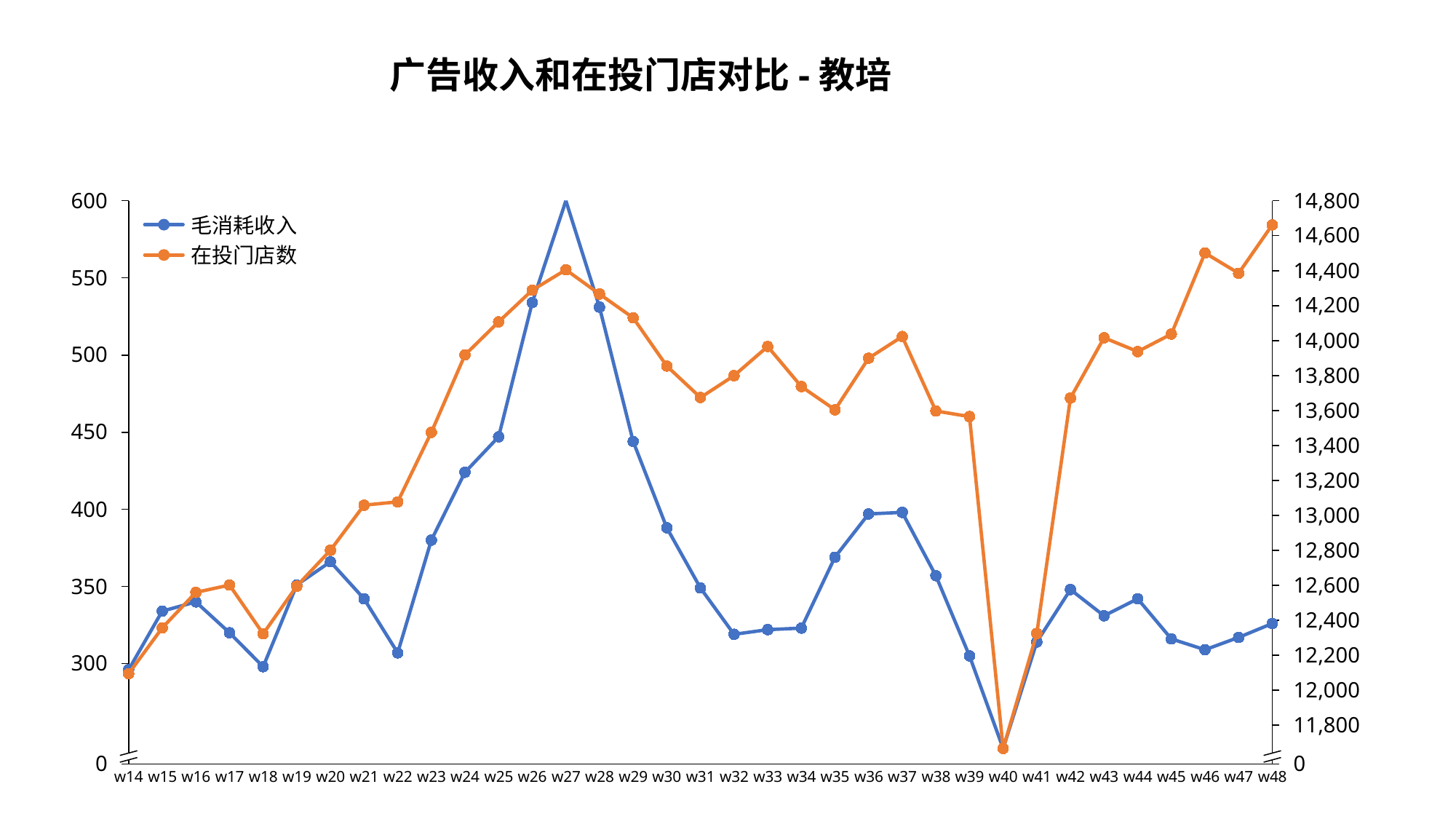
In which week does 在投门店数 reach its lowest value? w40 How many weeks are plotted along the x axis? 35 Is the value of 毛消耗收入 for w26 greater or less than 500? greater Does 在投门店数 rise or fall from w40 to w48? rise In which week does 毛消耗收入 reach its lowest value? w40 In which week does 毛消耗收入 reach its highest value? w27 Is the value of 毛消耗收入 for w22 greater or less than 350? less Which week has the higher 毛消耗收入, w16 or w18? w16 How many series does the legend list? 2 What kind of chart is shown on the slide? line chart Is the value of 在投门店数 for w48 greater or less than 14,600? greater